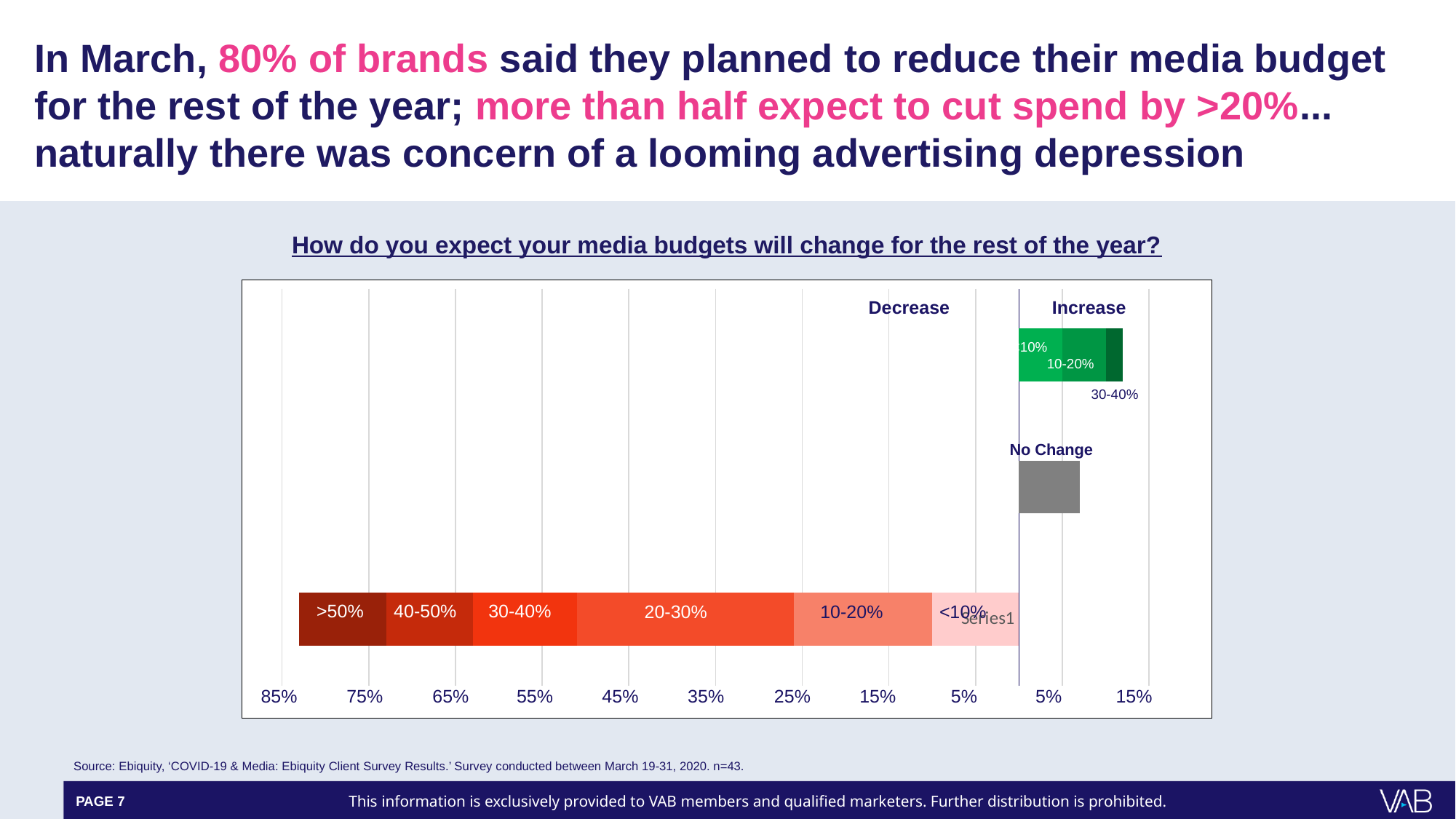
Is the value for No Change greater or less than 15%? less What colour are the Increase segments of the chart? Green How many segments make up the Decrease bar? 6 What is the title of the chart? How do you expect your media budgets will change for the rest of the year? Which Decrease segment is wider, 20-30% or 10-20%? 20-30% Is the total length of the Increase bar greater or less than 5%? greater How many segments make up the Increase bar? 3 Is the total length of the Decrease bar greater or less than 75%? greater Which segment of the Decrease bar is the widest? 20-30% Which of the three bars (Decrease, No Change, Increase) is the longest? Decrease What kind of chart is shown on the slide? Bar chart Which segment of the Increase bar is the narrowest? 30-40%